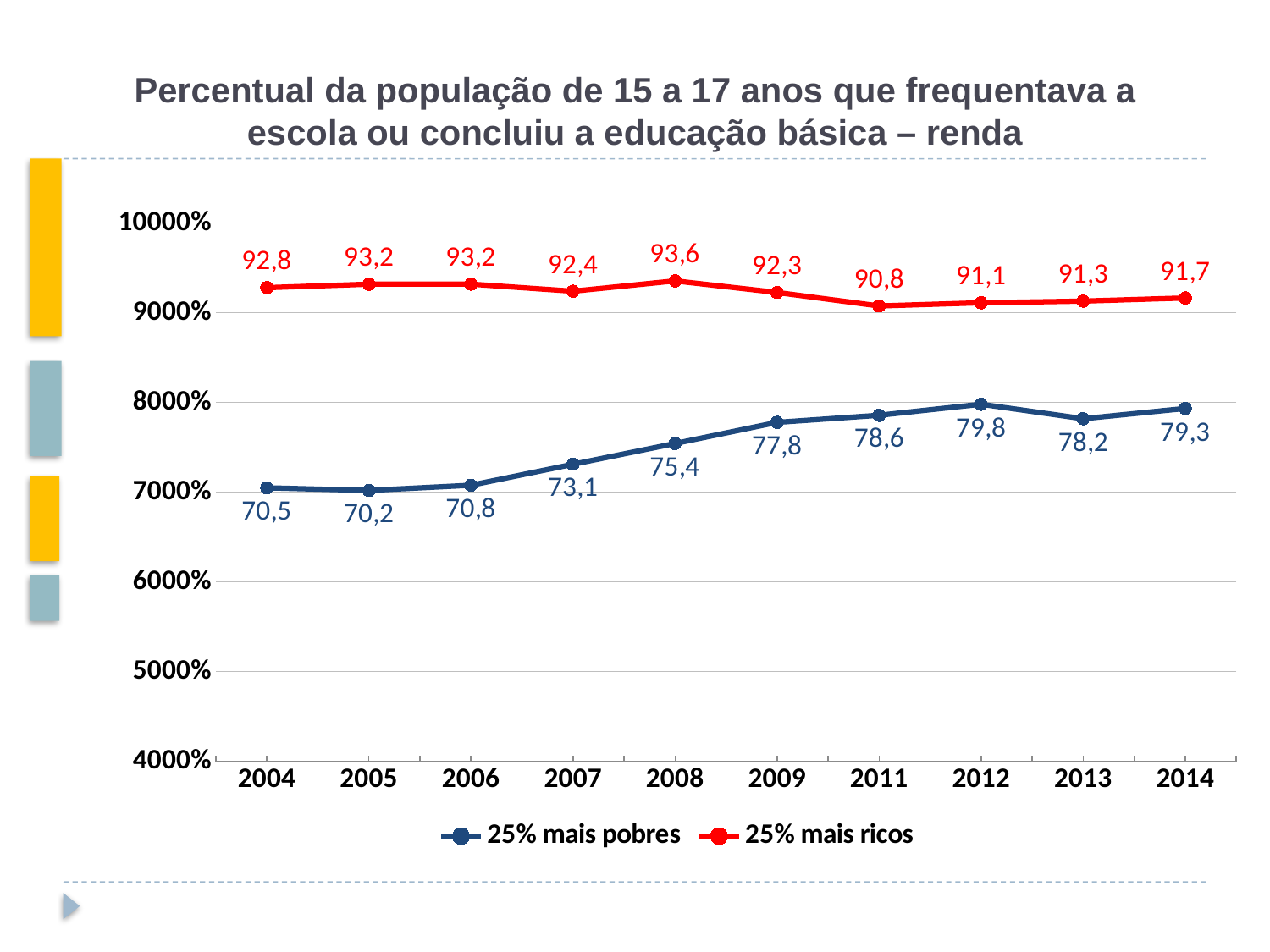
What is the difference between '25% mais ricos' and '25% mais pobres' in 2014? 12,4 How many years are shown on the x axis? 10 What kind of chart is shown on the slide? Line chart How many series does the legend list? 2 In which year does the '25% mais pobres' series have its lowest value? 2005 What is the difference between '25% mais ricos' and '25% mais pobres' in 2004? 22,3 In which year does the '25% mais ricos' series reach its highest value? 2008 What is the value for '25% mais pobres' in 2012? 79,8 In which year does the '25% mais ricos' series have its lowest value? 2011 What is the value for '25% mais pobres' in 2004? 70,5 What is the value for '25% mais ricos' in 2011? 90,8 Which series has the higher value in 2008, '25% mais pobres' or '25% mais ricos'? 25% mais ricos